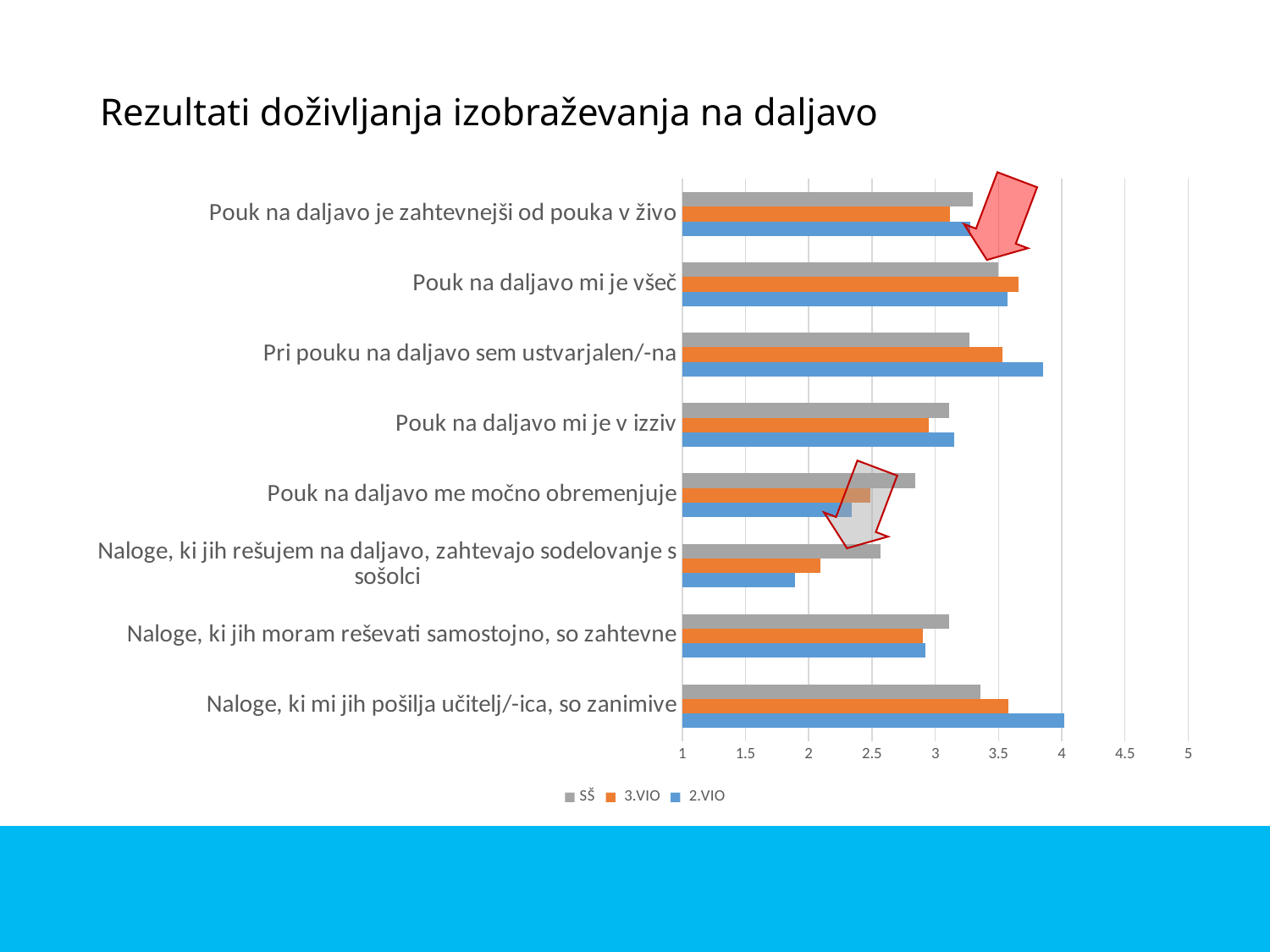
For which statement is the 2.VIO value the highest? Naloge, ki mi jih pošilja učitelj/-ica, so zanimive What kind of chart is shown on the slide? bar chart Which series is shown in orange? 3.VIO For "Naloge, ki jih rešujem na daljavo, zahtevajo sodelovanje s sošolci", which is larger: the SŠ value or the 2.VIO value? SŠ Is the 2.VIO value for "Pri pouku na daljavo sem ustvarjalen/-na" greater or less than 3.5? greater What are the series names listed in the legend? SŠ, 3.VIO, 2.VIO For "Pri pouku na daljavo sem ustvarjalen/-na", which is larger: the 2.VIO value or the SŠ value? 2.VIO For which statement is the 2.VIO value the lowest? Naloge, ki jih rešujem na daljavo, zahtevajo sodelovanje s sošolci How many categories (statements) are plotted on the chart? 8 Is the 2.VIO value for "Naloge, ki jih rešujem na daljavo, zahtevajo sodelovanje s sošolci" greater or less than 2? less Is the SŠ value for "Pouk na daljavo me močno obremenjuje" greater or less than 2.5? greater How many series does the legend list? 3